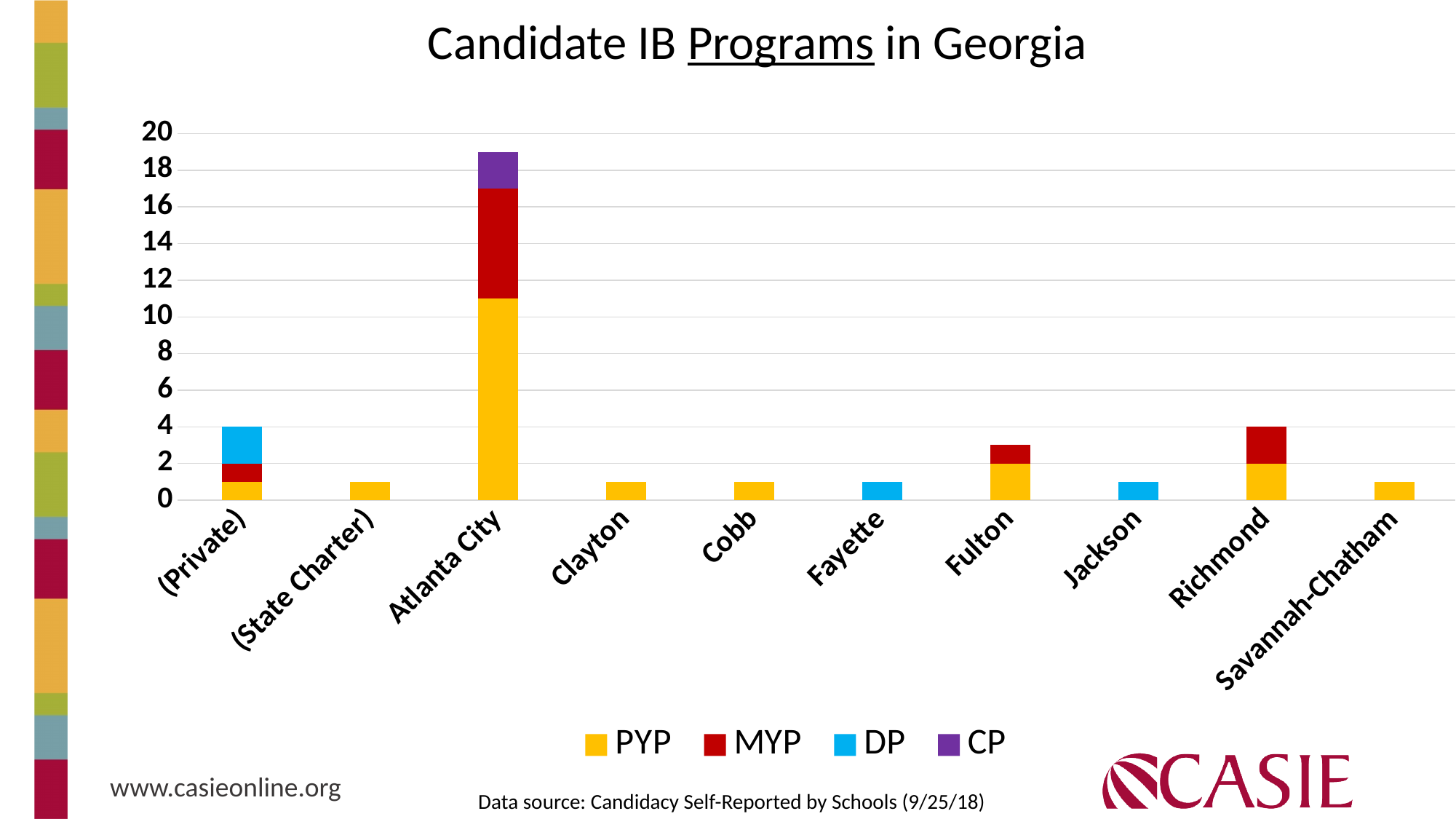
Which series is shown in purple in the legend? CP What is the PYP value for Fulton? 2 How many categories are shown along the x axis? 10 How many series does the legend list? 4 Which has a taller bar, Richmond or Fulton? Richmond What is the total height of the stacked bar for Richmond? 4 What is the title of the chart? Candidate IB Programs in Georgia Is the value for Clayton greater or less than 2? less What is the total height of the stacked bar for (Private)? 4 What kind of chart is shown on the slide? Stacked bar chart Is the total value for Atlanta City greater or less than 10? greater Which category has the tallest bar? Atlanta City